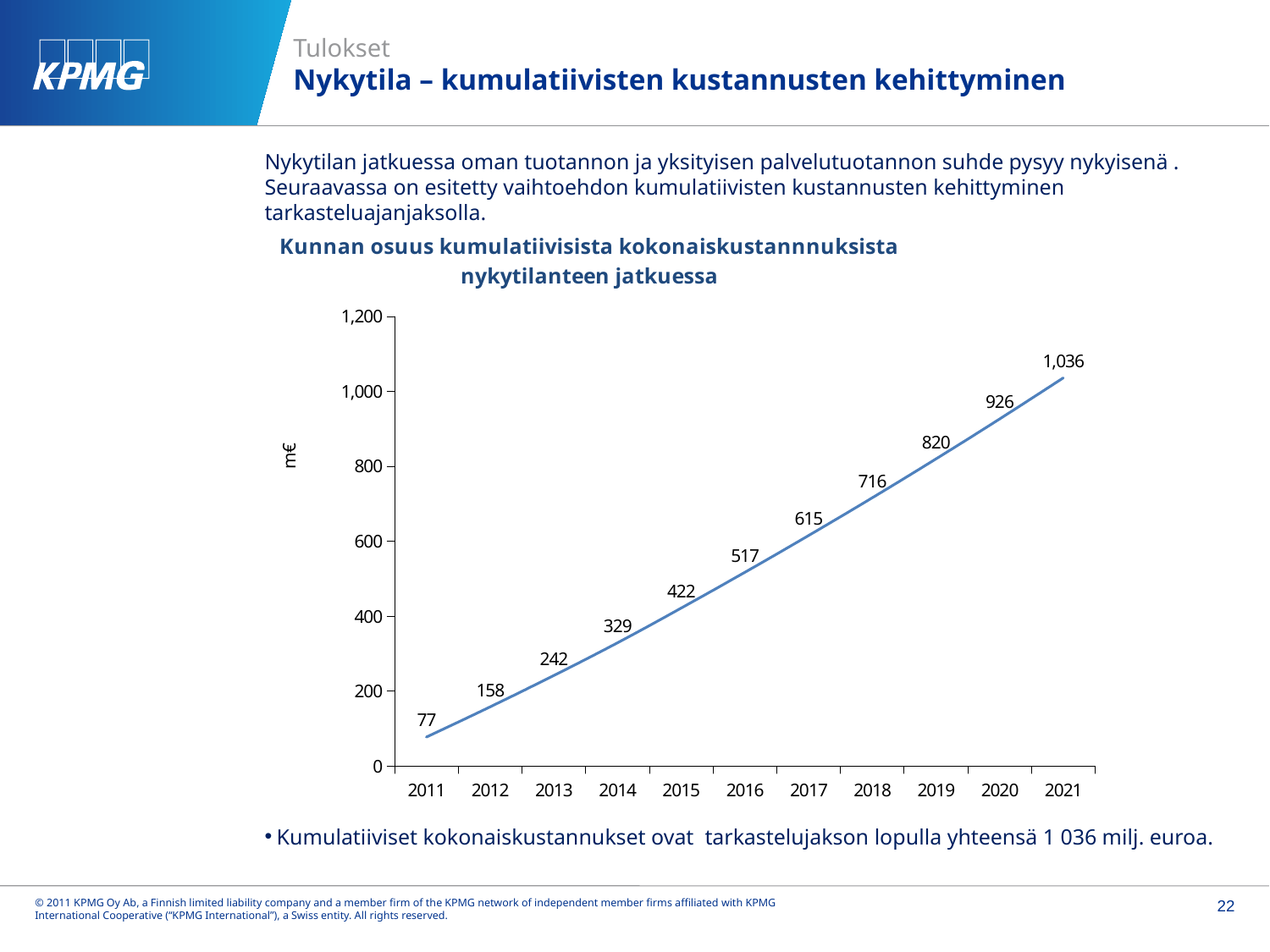
What is the difference between the values for 2021 and 2020? 110 Do the values rise or fall from 2011 to 2021? rise What is the value for 2015? 422 Which year has the lowest value? 2011 Which year has the highest value? 2021 What is the value for 2011? 77 What is the difference between the values for 2013 and 2012? 84 What kind of chart is shown? line chart How many years are plotted on the x axis? 11 Which is larger, the value for 2016 or the value for 2017? 2017 What is the value for 2018? 716 What is the value for 2021? 1,036